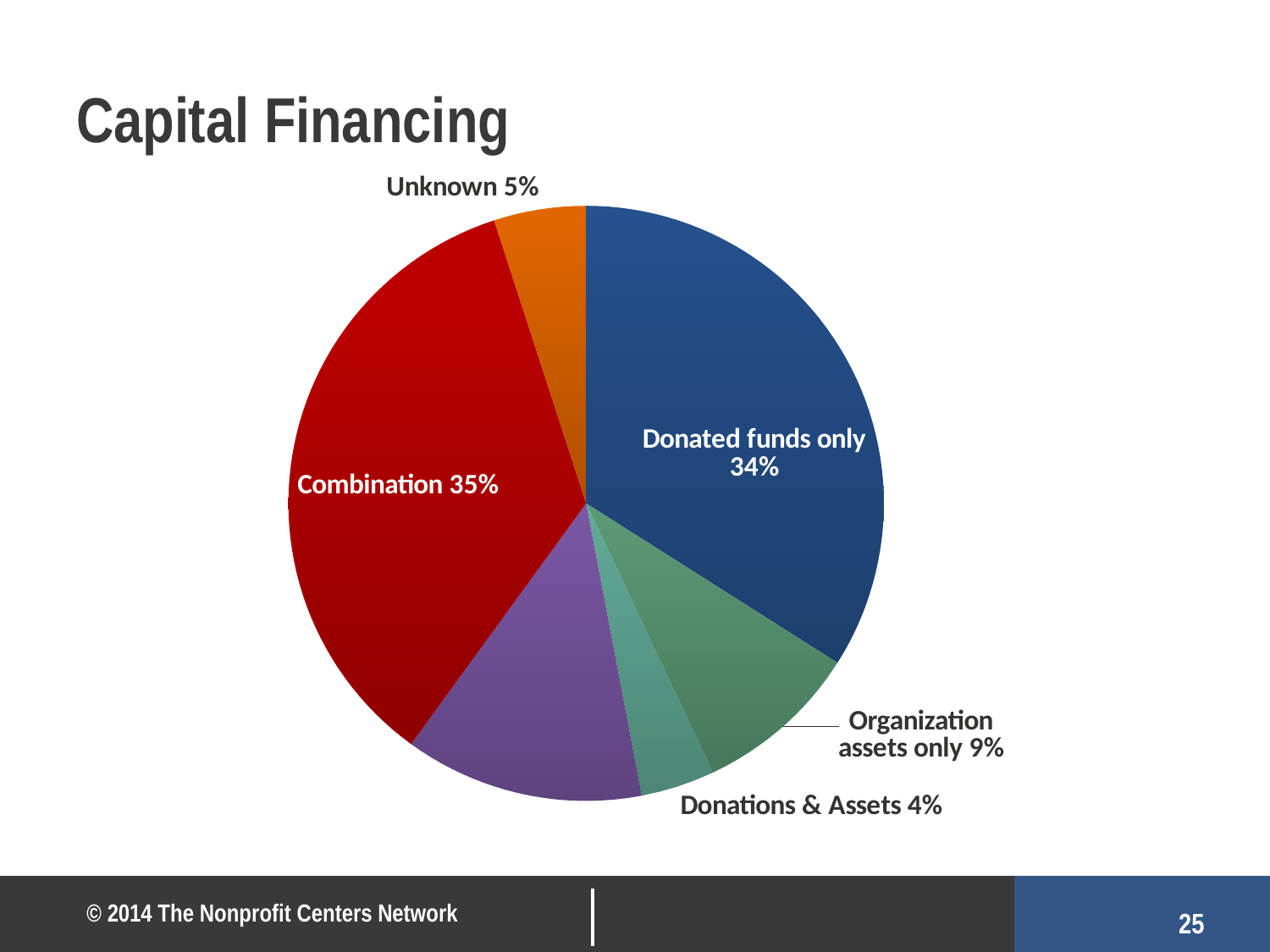
What is the title of the chart on the slide? Capital Financing What share of the pie does Combination represent? 35% What share of the pie does Donated funds only represent? 34% What is the value shown for Donations & Assets? 4% Which is larger, Organization assets only or Unknown? Organization assets only Which labelled slice has the smallest share of the pie? Donations & Assets What is the difference in percentage points between Donated funds only and Organization assets only? 25 Which labelled slice has the largest share of the pie? Combination What is the value shown for Organization assets only? 9% What kind of chart is shown on the slide? pie chart What is the value shown for Unknown? 5% What colour is the Combination slice? red